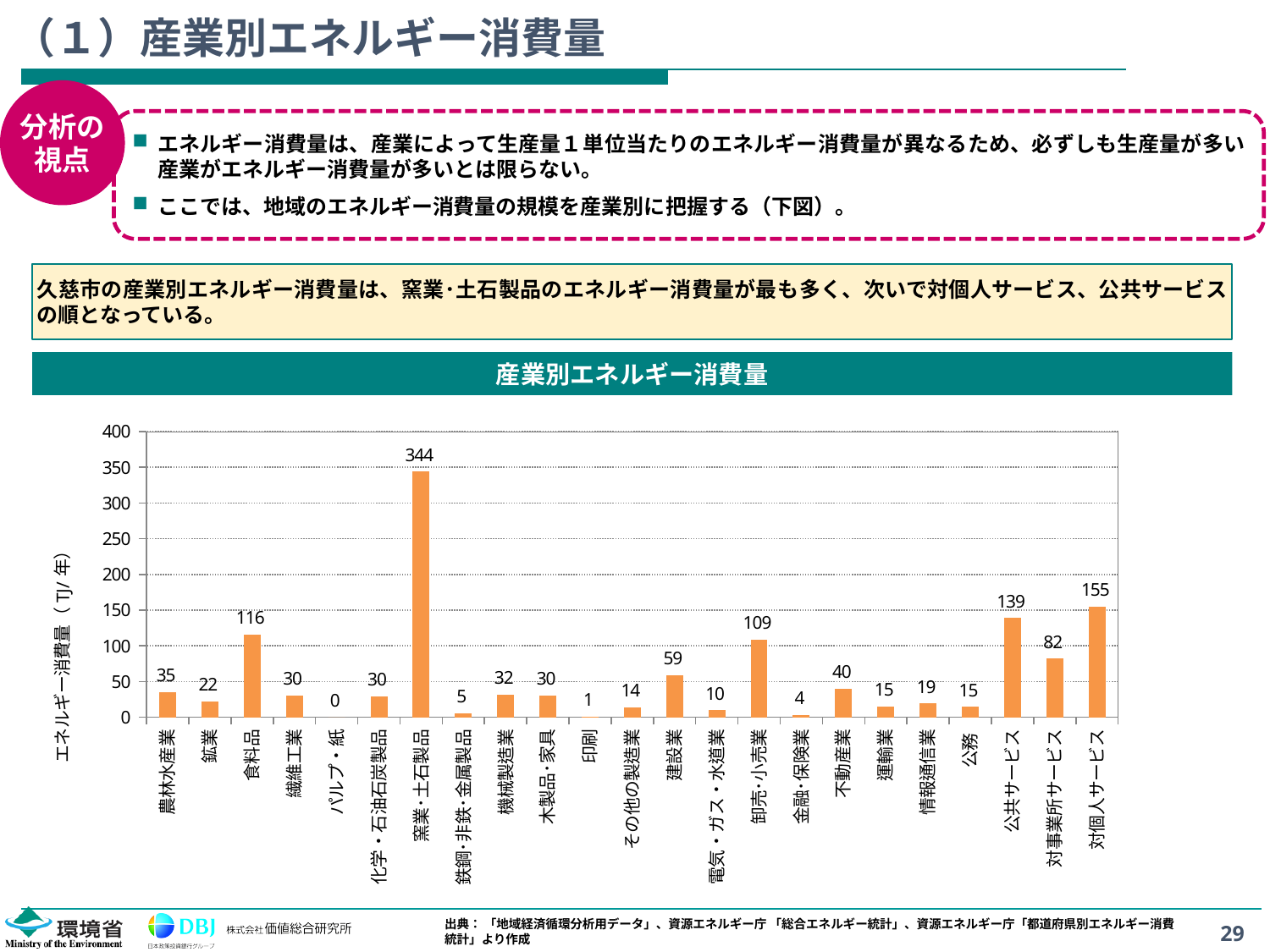
建設業と不動産業では、どちらのエネルギー消費量が多いですか？ 建設業 エネルギー消費量が最も少ない産業はどれですか？ パルプ・紙 対個人サービスと公共サービスのエネルギー消費量の差はいくらですか？ 16 縦軸の単位は何ですか？ TJ/年 卸売・小売業のエネルギー消費量はいくらですか？ 109 食料品と卸売・小売業では、どちらのエネルギー消費量が多いですか？ 食料品 このグラフの種類は何ですか？ 棒グラフ エネルギー消費量が最も多い産業はどれですか？ 窯業・土石製品 窯業・土石製品のエネルギー消費量はいくらですか？ 344 対個人サービスのエネルギー消費量はいくらですか？ 155 グラフには何種類の産業が示されていますか？ 23 窯業・土石製品と食料品のエネルギー消費量の差はいくらですか？ 228